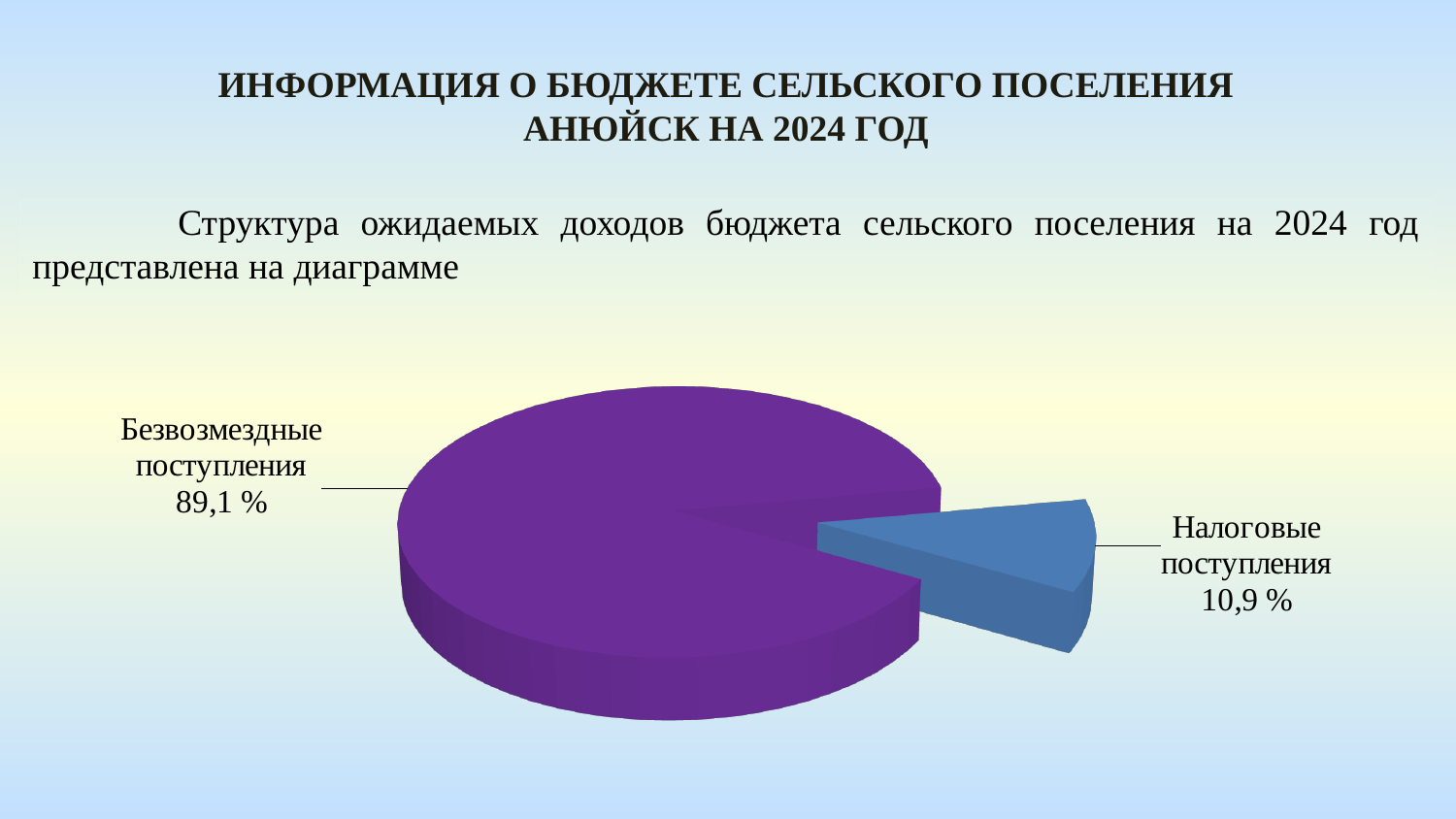
What is the difference in percentage points between Безвозмездные поступления and Налоговые поступления? 78,2 What colour is the slice for Безвозмездные поступления? Purple What share of the pie is labelled Налоговые поступления? 10,9 % How many slices does the pie chart have? 2 Which slice of the pie chart is the smallest? Налоговые поступления What is the total of the two slice percentages shown on the pie chart? 100 % Which is larger: Безвозмездные поступления or Налоговые поступления? Безвозмездные поступления What colour is the slice for Налоговые поступления? Blue What share of the pie is labelled Безвозмездные поступления? 89,1 % What kind of chart is shown on the slide? Pie chart Which slice of the pie chart is the largest? Безвозмездные поступления